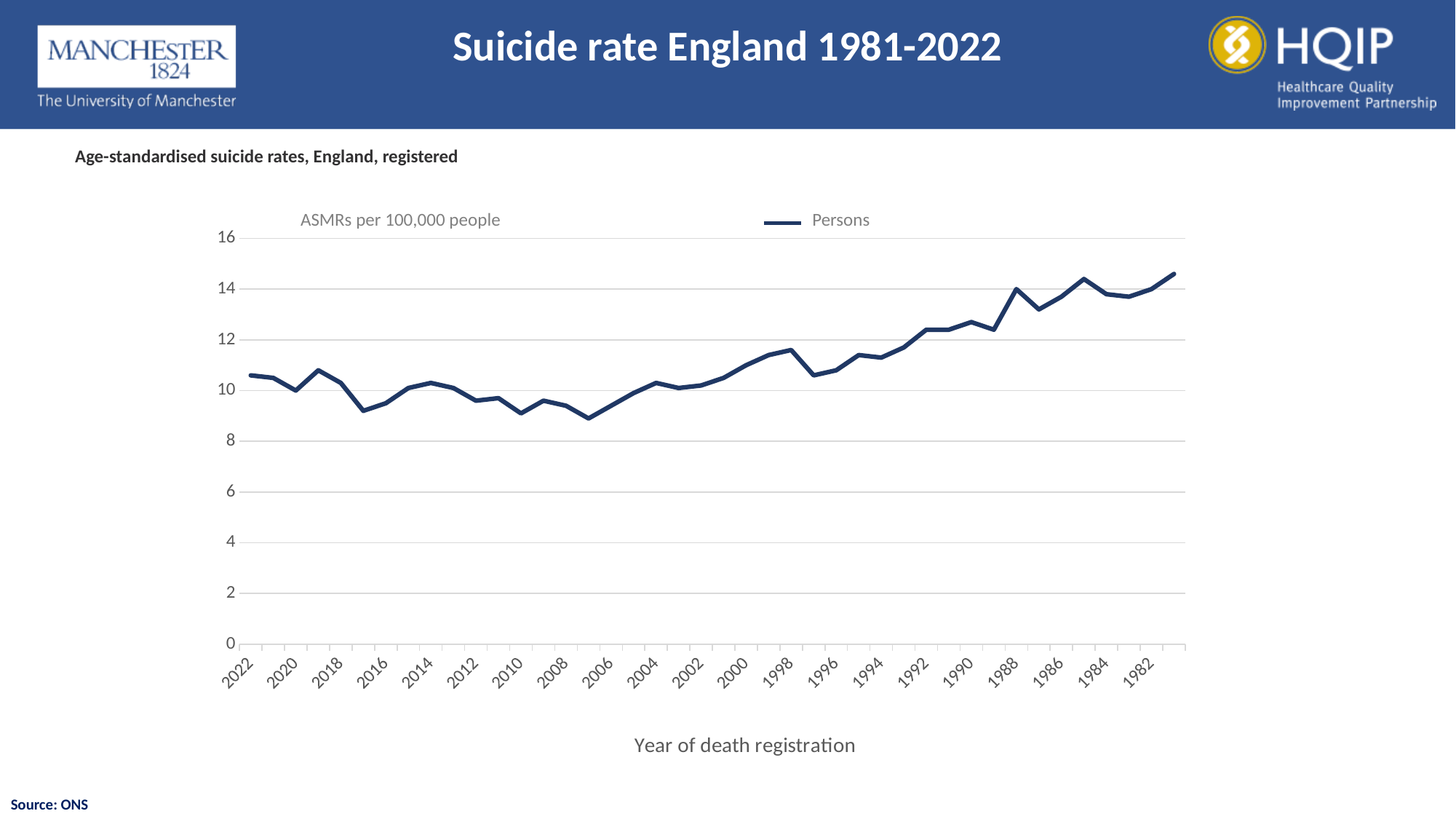
What kind of chart is shown on the slide? line chart How many series does the legend list? 1 Is the value for 1998 greater or less than 12? less Is the value for 2016 greater or less than 10? less Which year has the larger value, 1988 or 2022? 1988 What is the name of the series shown in the legend? Persons Which year has the larger value, 1998 or 2016? 1998 Moving left to right along the x axis (from 2022 towards 1981), do the values generally rise or fall? rise What is the title of the x axis? Year of death registration Is the value for 2022 greater or less than 10? greater